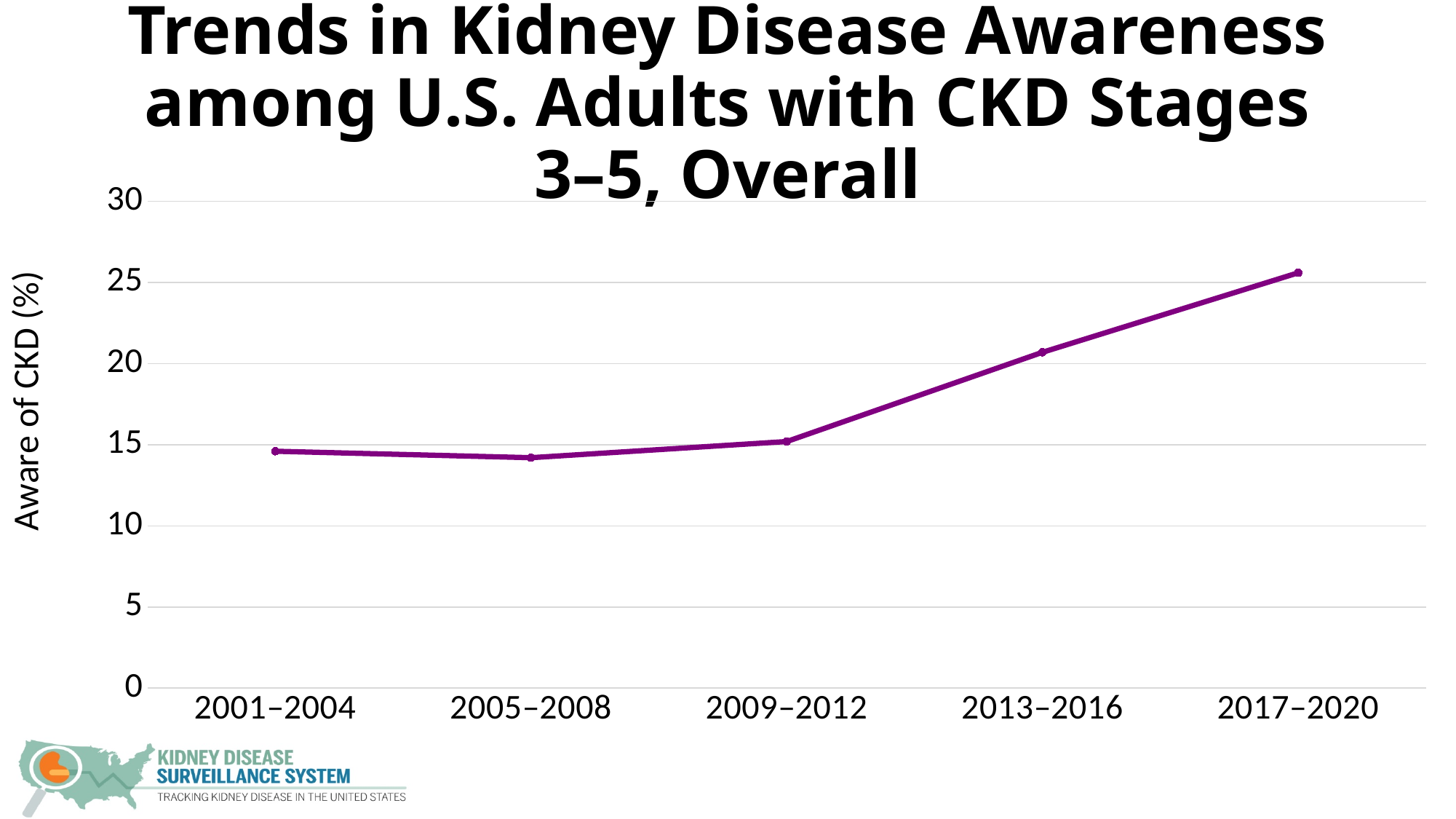
What is the label of the y axis? Aware of CKD (%) Which time period has the highest percentage aware of CKD? 2017–2020 Is the value for 2001–2004 greater or less than 10? greater Is the value for 2009–2012 greater or less than 20? less What kind of chart is shown on the slide? line chart Which is larger, the value for 2013–2016 or the value for 2009–2012? 2013–2016 Is the value for 2005–2008 greater or less than 15? less What is the title of the chart? Trends in Kidney Disease Awareness among U.S. Adults with CKD Stages 3–5, Overall Does the percentage aware of CKD rise or fall from 2009–2012 to 2017–2020? rise How many time periods are plotted on the x axis? 5